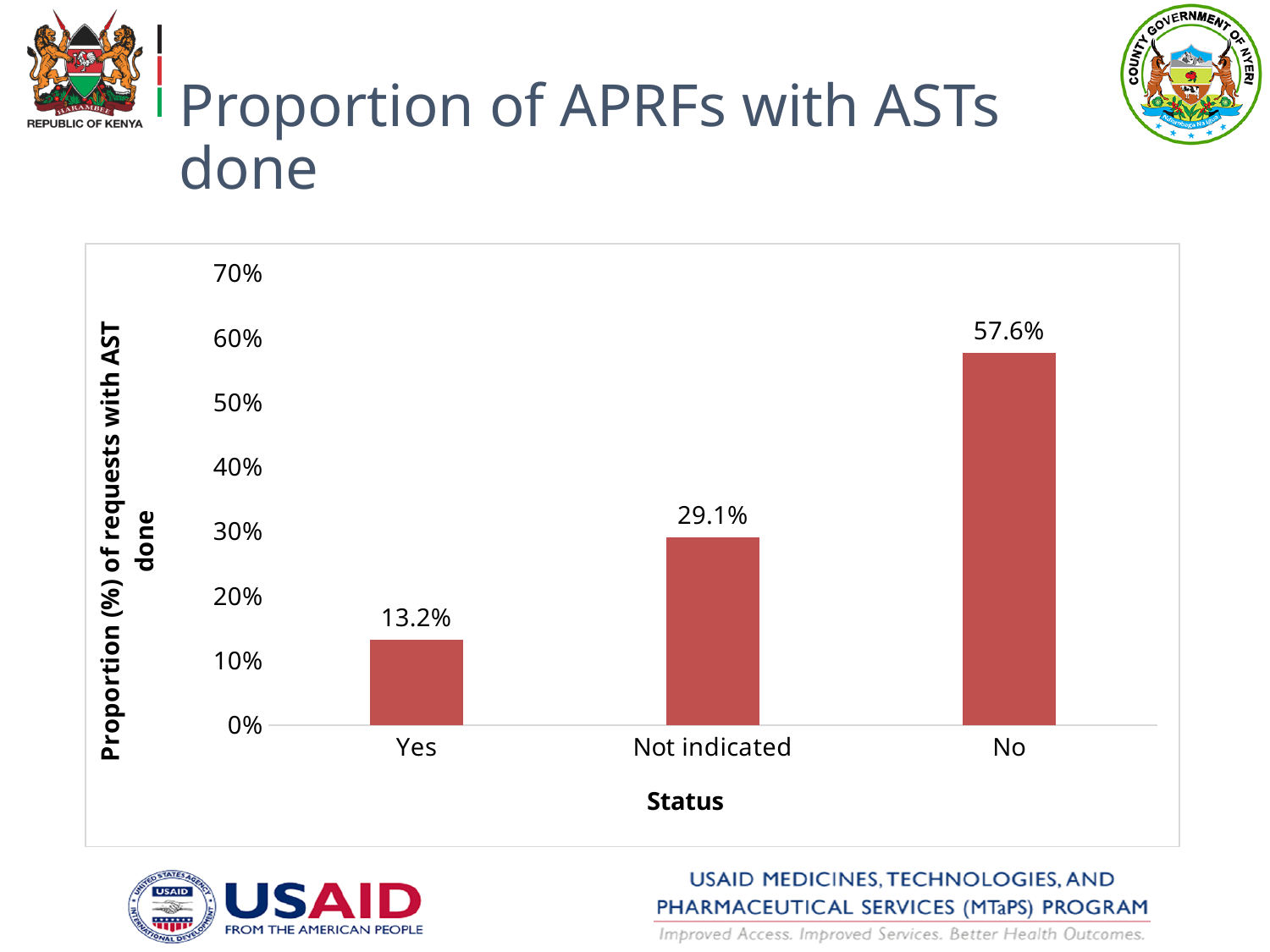
Which category has the highest value? No How many categories are shown on the x axis? 3 What is the value for the "No" category? 57.6% What kind of chart is shown on the slide? Bar chart What is the difference between the values for "Not indicated" and "Yes"? 15.9% Is the value for "No" greater or less than 50%? greater What is the value for the "Yes" category? 13.2% What is the difference between the values for "No" and "Yes"? 44.4% Which is larger, the value for "Not indicated" or the value for "Yes"? Not indicated Which category has the lowest value? Yes What is the value for the "Not indicated" category? 29.1% What is the label of the x axis? Status